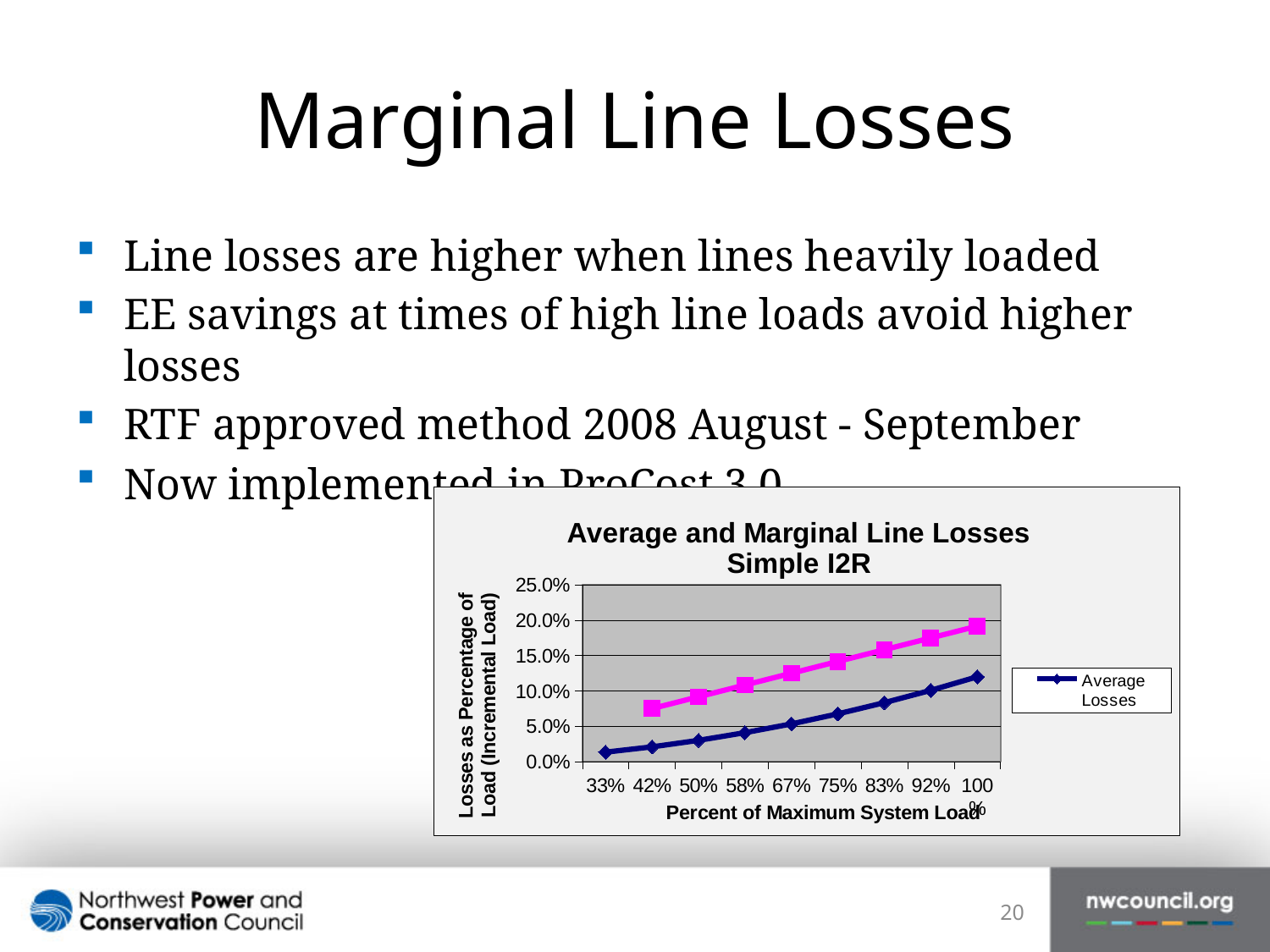
Do the Average Losses values rise or fall as the percent of maximum system load increases? rise How many points along the x axis are plotted for the Average Losses series? 9 What is the label of the x axis of the chart? Percent of Maximum System Load Is the value of the upper (magenta) line at 100% greater or less than 15.0%? greater Is the value of the upper (magenta) line at 42% greater or less than 10.0%? less At 100% of maximum system load, which line is higher, the magenta line or the blue Average Losses line? the magenta line What kind of chart is shown on the slide? line chart Is the Average Losses value at 33% greater or less than 5.0%? less Which series does the legend list? Average Losses What is the title of the chart? Average and Marginal Line Losses Simple I2R